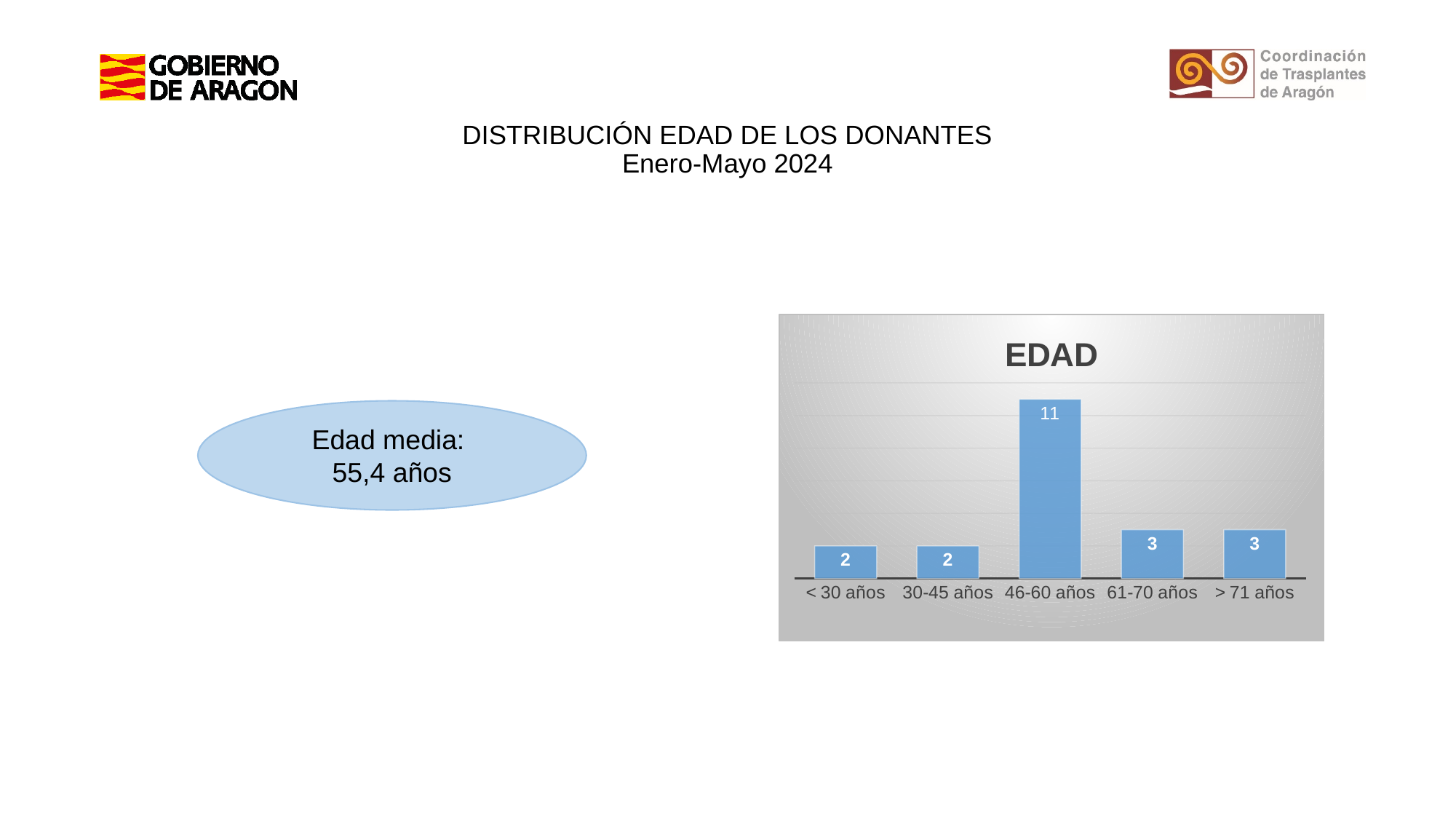
What kind of chart is the EDAD chart? bar chart What is the value for the < 30 años category in the EDAD chart? 2 Which is larger in the EDAD chart, the value for 46-60 años or the value for > 71 años? 46-60 años What is the difference between the values for 46-60 años and 61-70 años in the EDAD chart? 8 How many categories are shown in the EDAD chart? 5 What is the title of the chart on the slide? EDAD What is the value for the 46-60 años category in the EDAD chart? 11 Which category has the highest value in the EDAD chart? 46-60 años What is the difference between the values for 61-70 años and 30-45 años in the EDAD chart? 1 What is the total of all the values shown in the EDAD chart? 21 What is the value for the 61-70 años category in the EDAD chart? 3 What is the value for the > 71 años category in the EDAD chart? 3